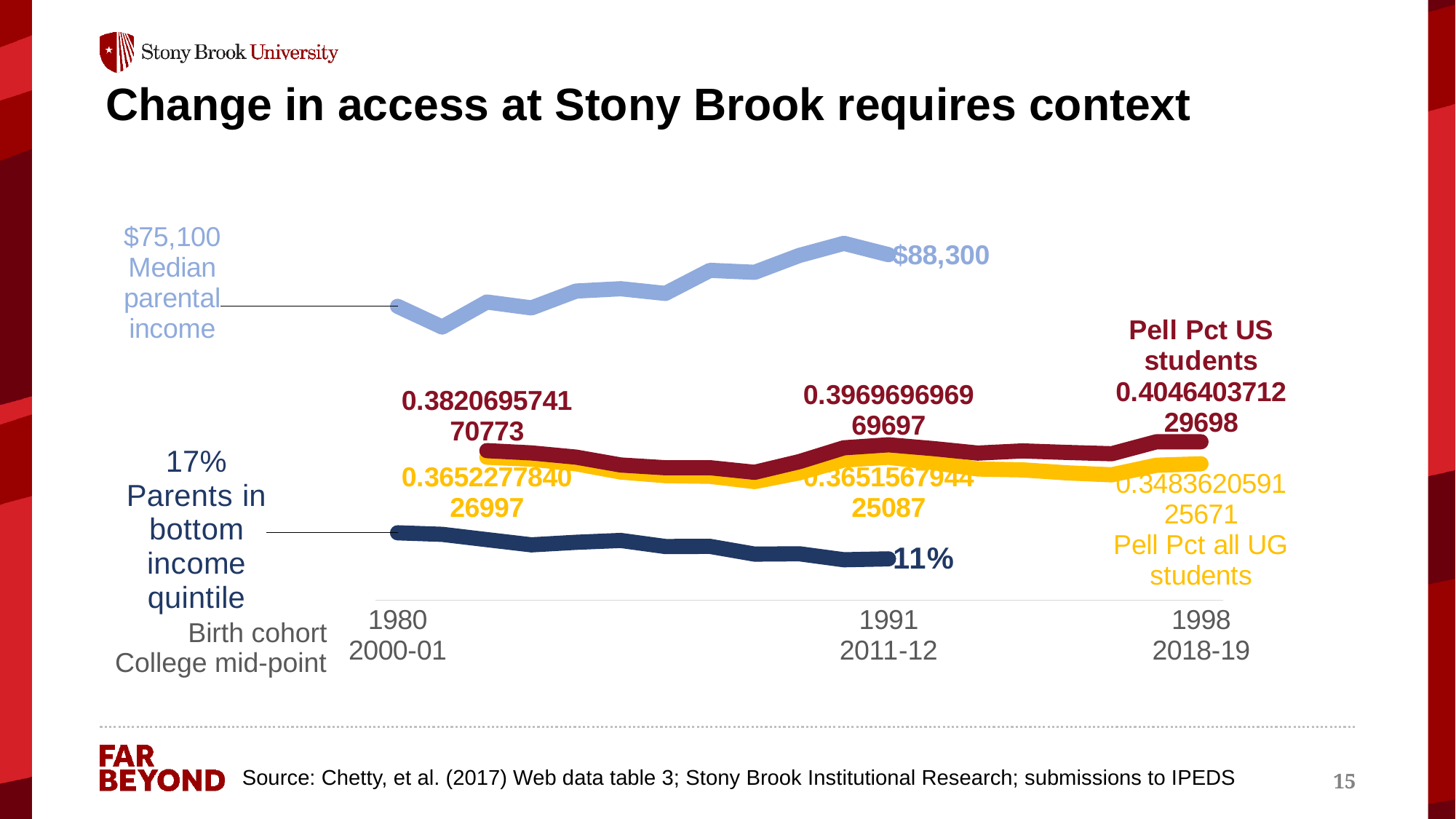
What is the median parental income for the 1980 birth cohort (college mid-point 2000-01)? $75,100 By how many percentage points did the share of parents in the bottom income quintile change from 17% to 11%? 6 percentage points What share of parents were in the bottom income quintile for the 1980 birth cohort? 17% What is the Pell Pct all UG students value labelled at the 1991 / 2011-12 point? 0.365156794425087 What is the Pell Pct US students value labelled at the 1998 / 2018-19 point? 0.404640371229698 What type of chart is shown on the slide? line chart What is the difference between the median parental income of $88,300 and $75,100? $13,200 Does the 'Parents in bottom income quintile' line rise or fall across the x axis? fall At the 2018-19 point, which is higher: Pell Pct US students or Pell Pct all UG students? Pell Pct US students